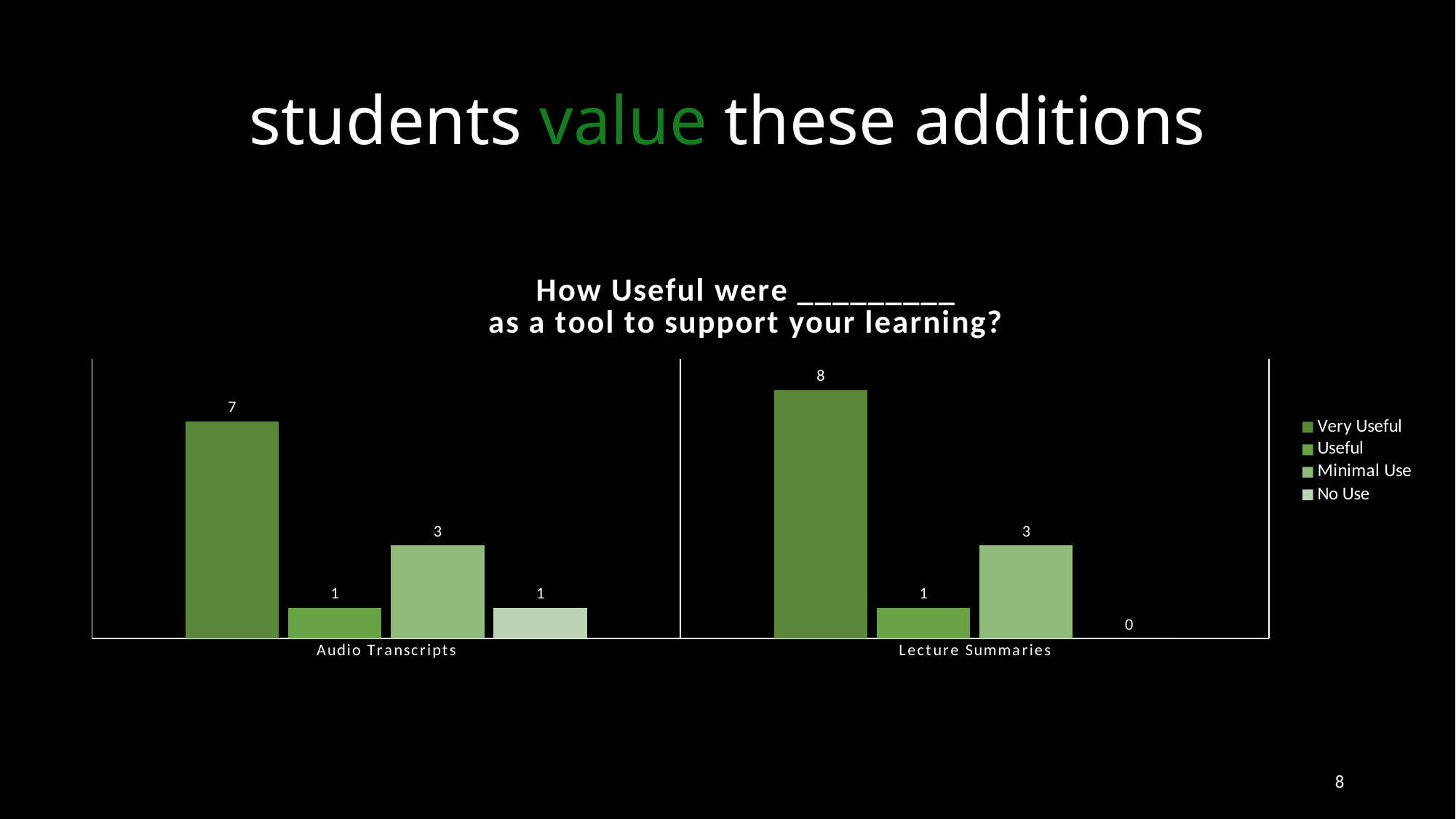
What is the value for No Use for Lecture Summaries? 0 Which is larger: the Very Useful count for Audio Transcripts or for Lecture Summaries? Lecture Summaries How many series does the legend list? 4 What kind of chart is shown on the slide? Bar chart What is the value for Minimal Use for Lecture Summaries? 3 How many students rated Audio Transcripts as Very Useful? 7 What is the difference between the Very Useful counts for Lecture Summaries and Audio Transcripts? 1 What is the total number of responses for Audio Transcripts across all four ratings? 12 Which rating has the highest value for Audio Transcripts? Very Useful How many students rated Lecture Summaries as Very Useful? 8 Which rating has the lowest value for Lecture Summaries? No Use How many categories are shown on the x axis? 2